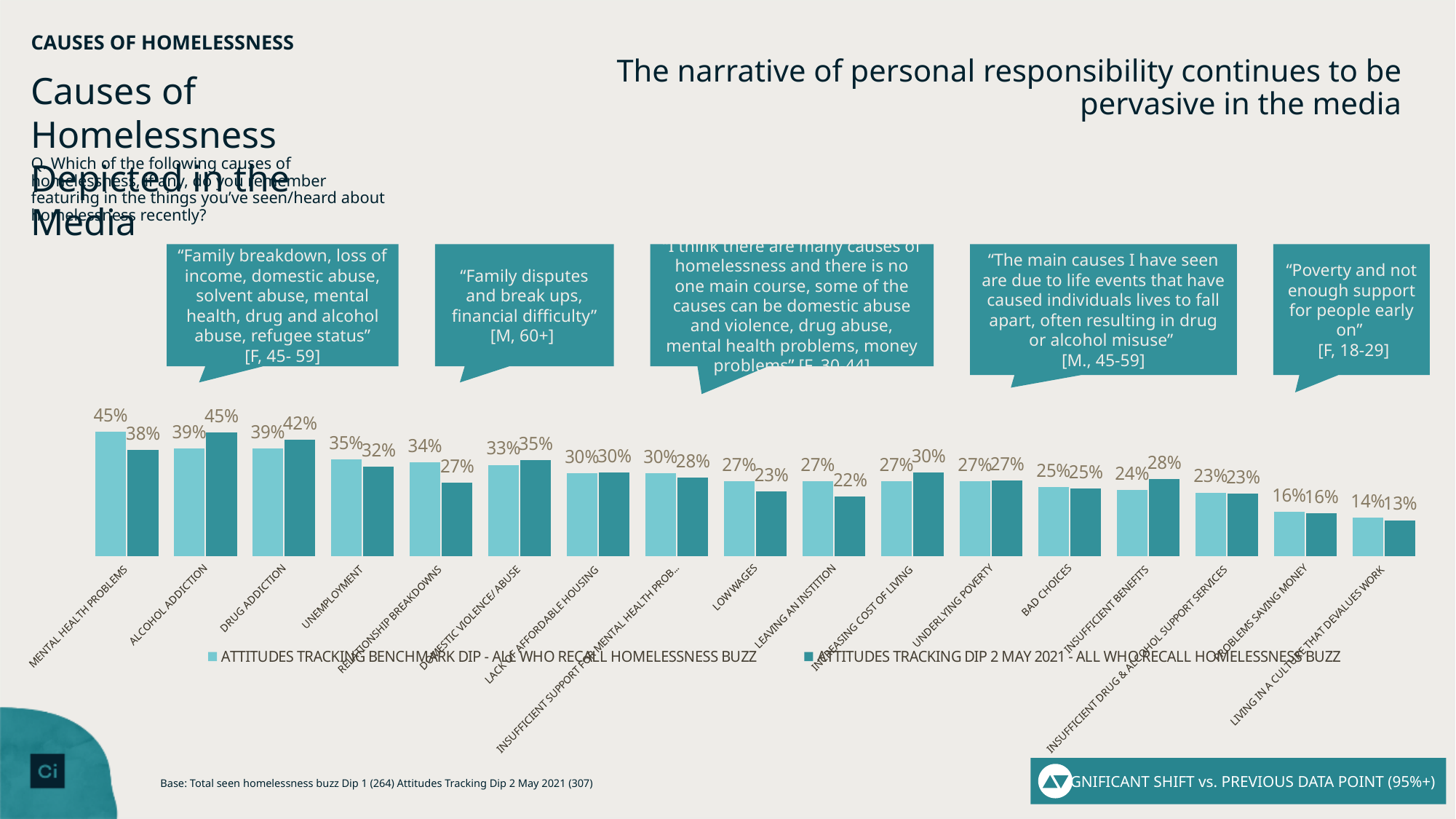
Which category has the highest value in the Attitudes Tracking Benchmark Dip series? Mental health problems What is the difference between the Benchmark Dip and Dip 2 May 2021 values for Mental Health Problems? 7% How many series does the legend list? 2 What is the value for Alcohol Addiction in the Attitudes Tracking Dip 2 May 2021 series? 45% What is the value for Leaving an Institution in the Attitudes Tracking Dip 2 May 2021 series? 22% How many categories are shown on the x axis of the chart? 17 Which colour represents the Attitudes Tracking Dip 2 May 2021 series in the chart? Dark teal What is the value for Mental Health Problems in the Attitudes Tracking Benchmark Dip series? 45% What kind of chart is shown on the slide? Bar chart For Insufficient Benefits, which series has the larger value: Benchmark Dip or Dip 2 May 2021? Attitudes Tracking Dip 2 May 2021 Which category has the lowest value in the Attitudes Tracking Dip 2 May 2021 series? Living in a culture that devalues work For Relationship Breakdowns, which series has the larger value: Benchmark Dip or Dip 2 May 2021? Attitudes Tracking Benchmark Dip